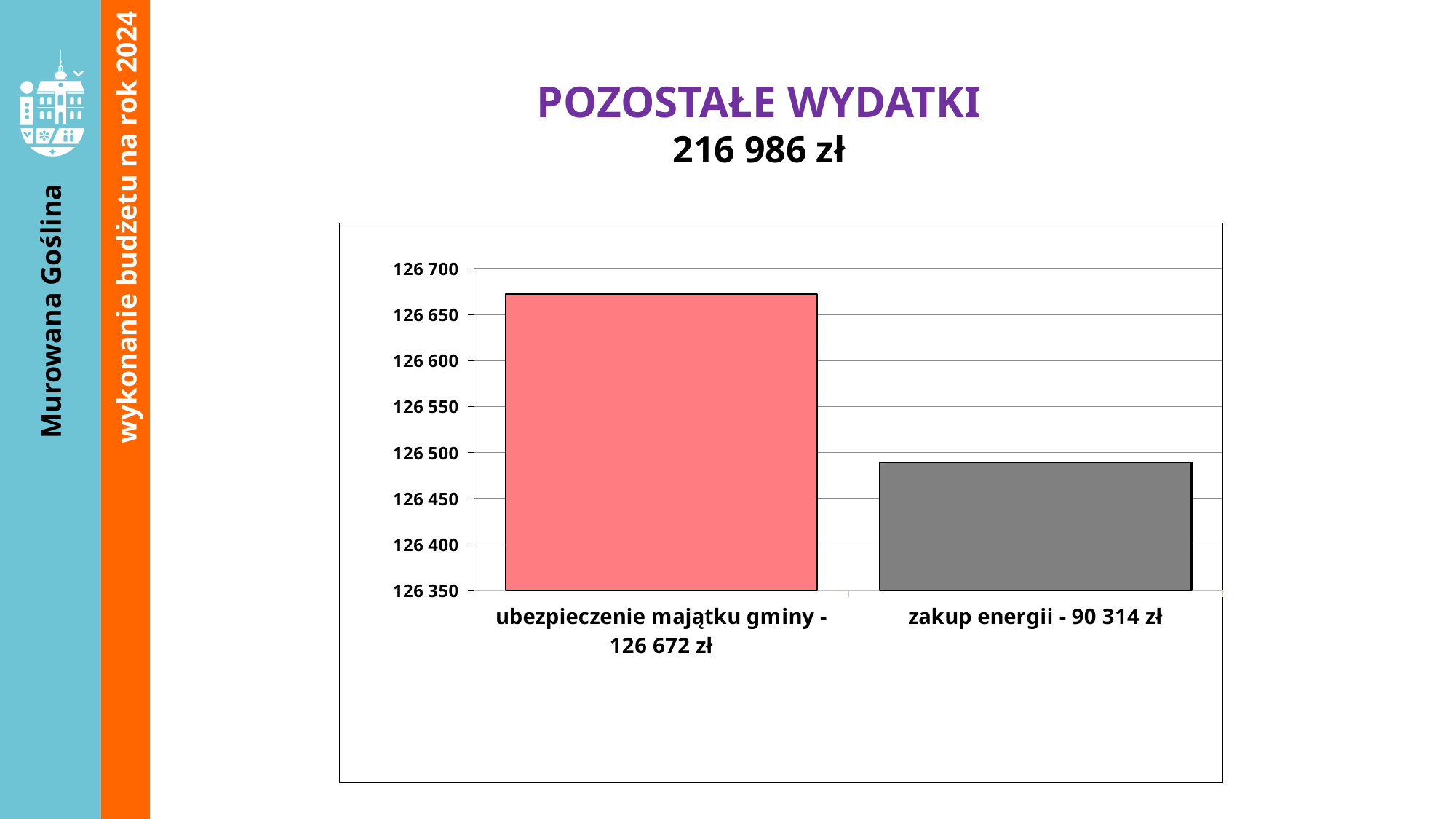
What total amount is shown under the chart title 'POZOSTAŁE WYDATKI'? 216 986 zł What is the title of the chart? POZOSTAŁE WYDATKI How many categories (bars) does the chart show? 2 Which is larger: the value for 'ubezpieczenie majątku gminy' or for 'zakup energii'? ubezpieczenie majątku gminy What colour is the bar for 'zakup energii'? grey Which category has the highest value? ubezpieczenie majątku gminy What is the value for 'ubezpieczenie majątku gminy' according to its label? 126 672 zł Is the bar for 'ubezpieczenie majątku gminy' greater or less than 126 650 on the axis? greater What is the difference between the labelled values for 'ubezpieczenie majątku gminy' (126 672 zł) and 'zakup energii' (90 314 zł)? 36 358 zł Which category has the lowest value? zakup energii What kind of chart is shown on the slide? bar chart What is the value for 'zakup energii' according to its label? 90 314 zł